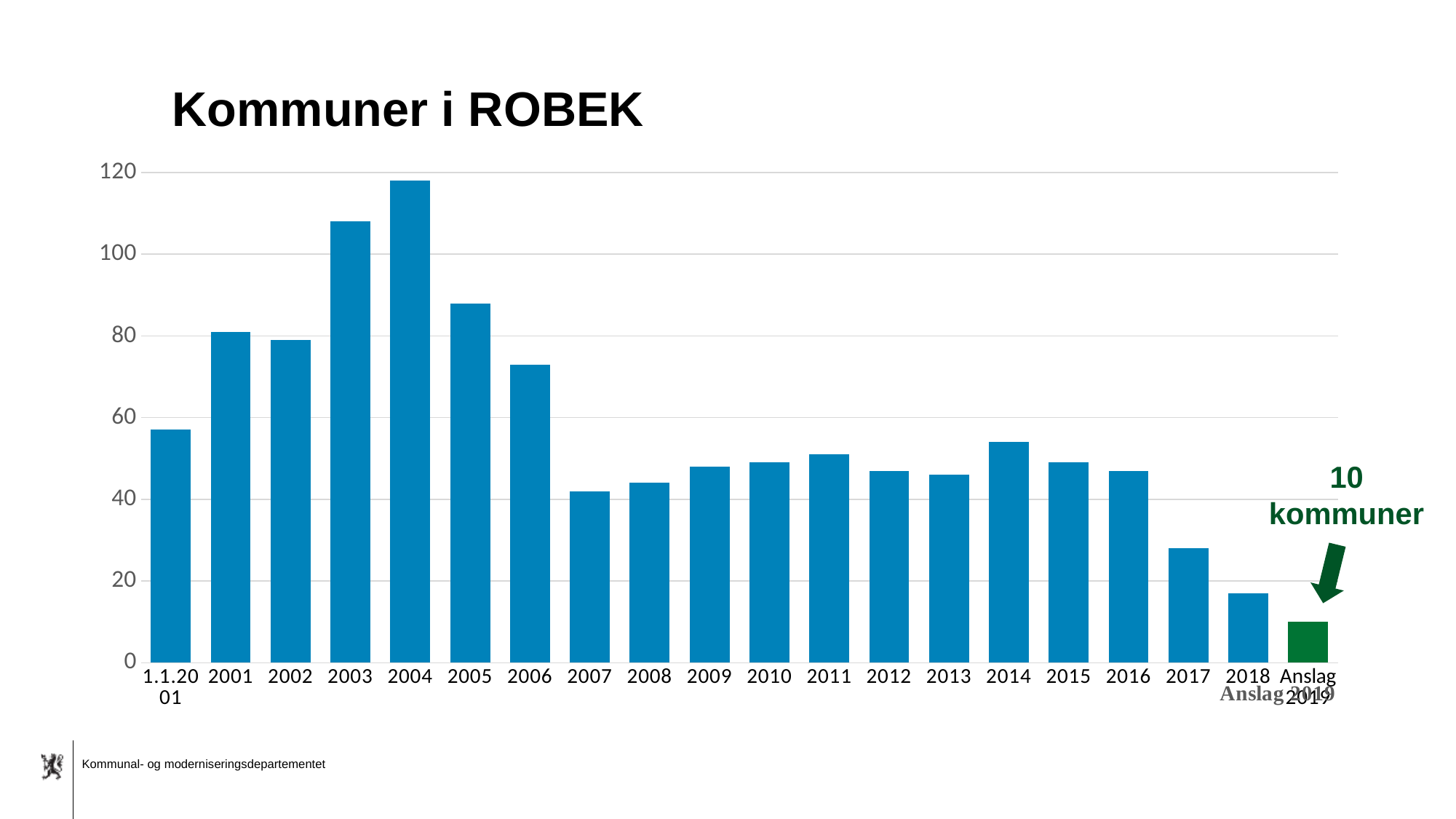
Is the value for 2004 greater or less than 100? greater Do the values rise or fall from 2004 to 2007? fall What is the value shown for Anslag 2019? 10 Is the value for 2018 greater or less than 20? less What kind of chart is shown on the slide? bar chart What colour is the bar for Anslag 2019? green What is the title of the chart? Kommuner i ROBEK Which is larger, the value for 2003 or the value for 2005? 2003 Which category has the lowest value in the chart? Anslag 2019 Is the value for 2005 greater or less than 100? less How many bars (categories) are plotted in the chart? 20 Which year has the highest number of kommuner i ROBEK? 2004